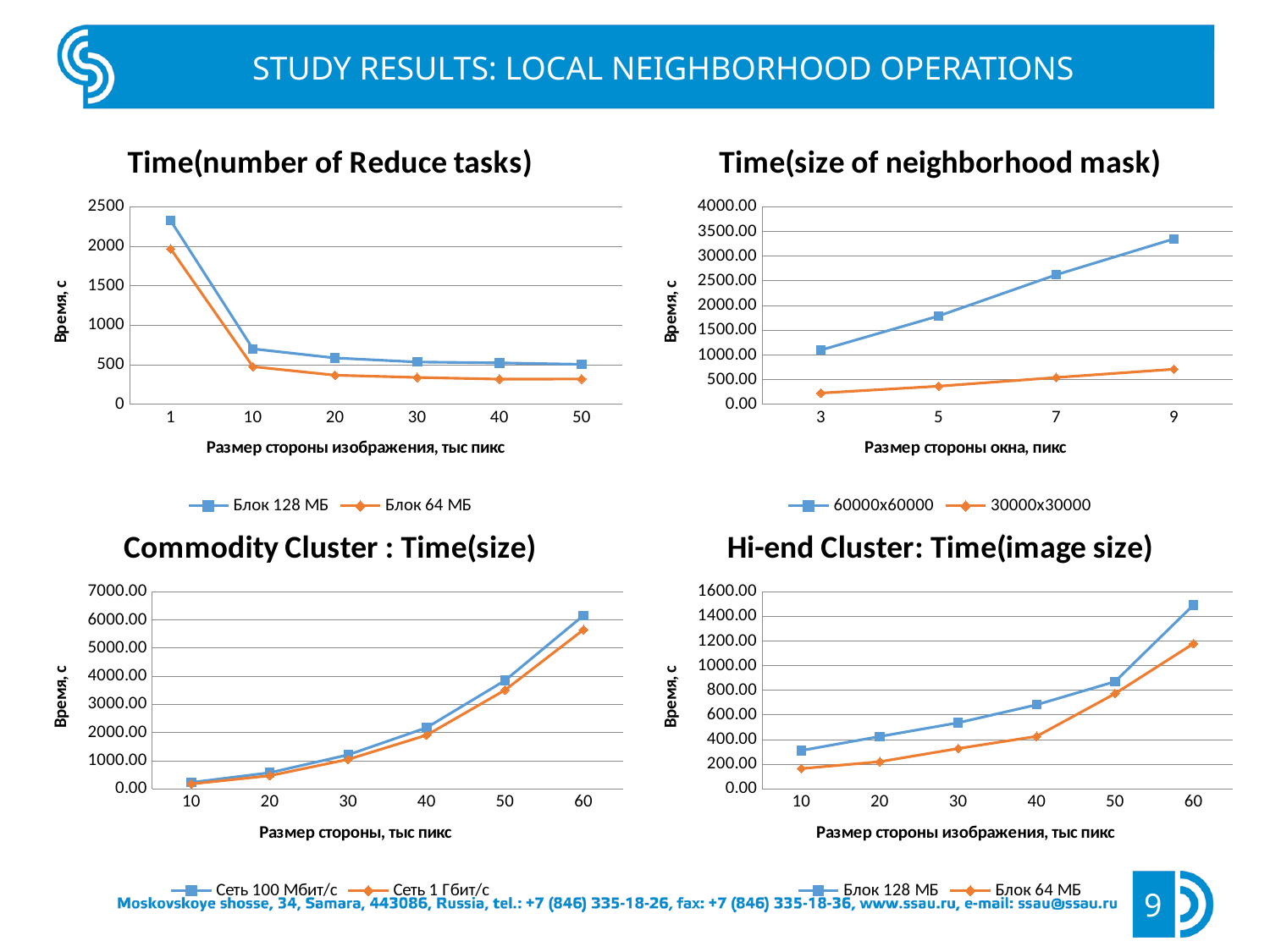
In the 'Time(size of neighborhood mask)' chart, is the value for 60000x60000 at x = 9 greater or less than 3000.00? greater In the 'Commodity Cluster : Time(size)' chart, is the value for Сеть 1 Гбит/с at x = 60 greater or less than 6000.00? less In the 'Hi-end Cluster: Time(image size)' chart, is the value for Блок 128 МБ at x = 60 greater or less than 1400.00? greater In the 'Time(size of neighborhood mask)' chart, at which window size is the 60000x60000 series highest? 9 What are the two legend entries of the 'Commodity Cluster : Time(size)' chart? Сеть 100 Мбит/с and Сеть 1 Гбит/с In the 'Time(size of neighborhood mask)' chart, how many x-axis points are plotted for each series? 4 In the 'Time(number of Reduce tasks)' chart, which series has the higher value at x = 1, Блок 128 МБ or Блок 64 МБ? Блок 128 МБ In the 'Time(number of Reduce tasks)' chart, how many series does the legend list? 2 What kind of chart is the 'Time(number of Reduce tasks)' chart? line chart In the 'Time(number of Reduce tasks)' chart, do the values rise or fall as the x axis increases? fall